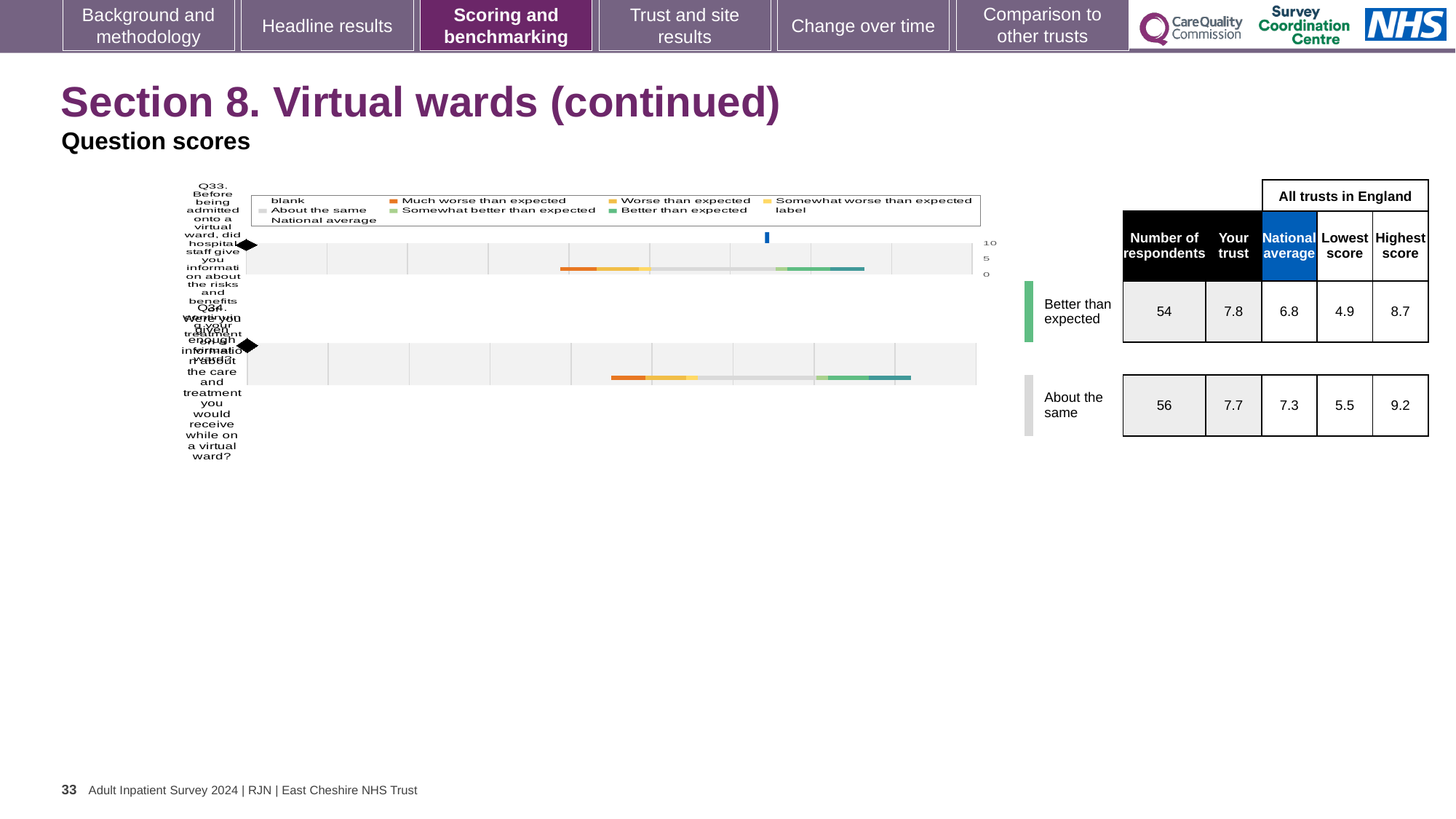
What is the national average score for Q33? 6.8 How many questions are plotted in the chart on this slide? 2 What is the highest score among all trusts in England for Q34? 9.2 Which question has the higher 'Your trust' score, Q33 or Q34? Q33 What kind of chart is used to show the question scores on this slide? bar chart How many respondents answered Q34? 56 Which two questions are plotted in the chart? Q33 and Q34 What is the national average score for Q34? 7.3 What benchmark category is Q33 placed in? Better than expected What is the difference between the trust's score and the national average for Q33? 1.0 What is the 'Your trust' score for Q34 (enough information about care and treatment on a virtual ward)? 7.7 What is the 'Your trust' score for Q33 (information about the risks and benefits of a virtual ward)? 7.8